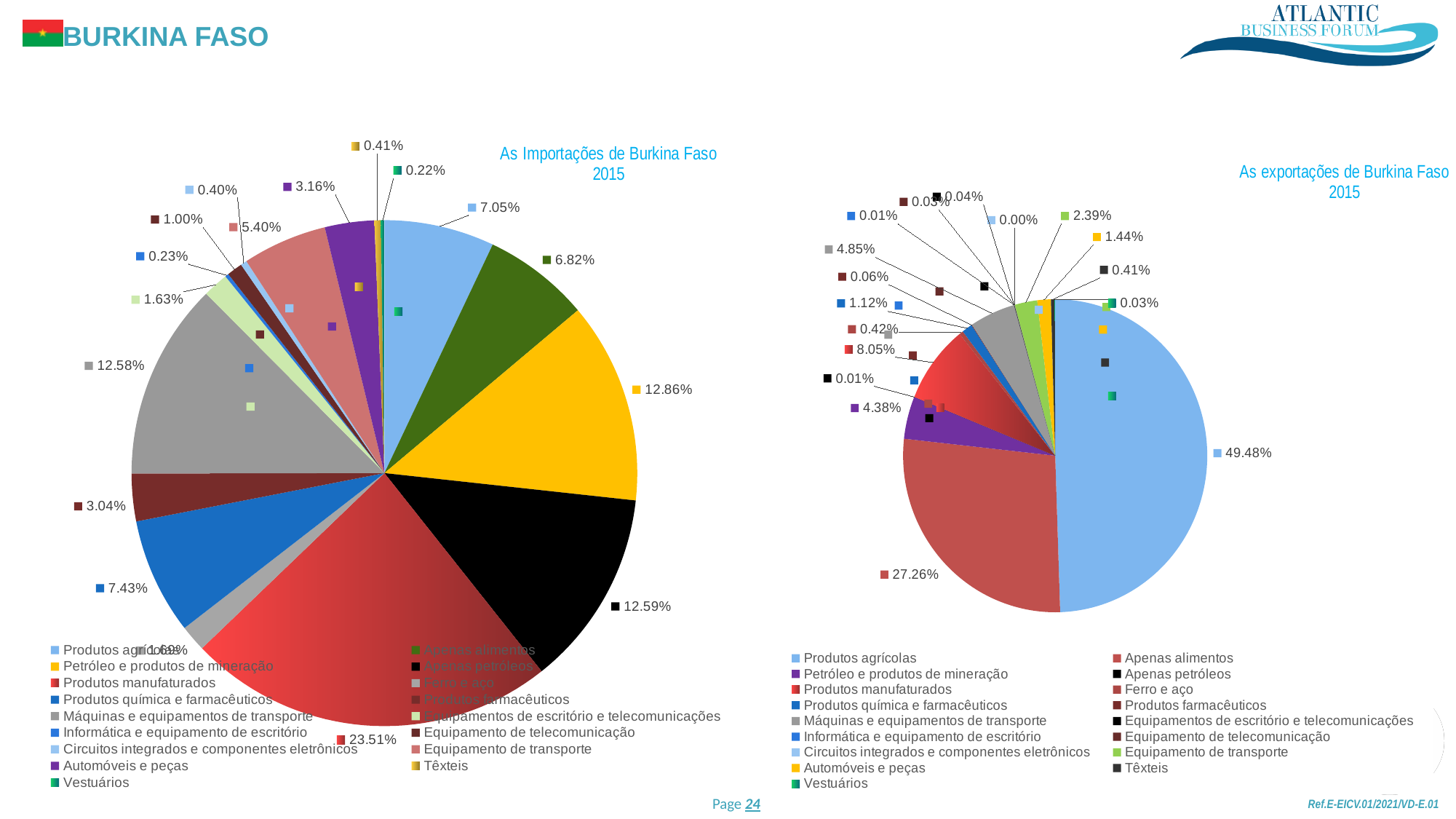
In the chart titled 'As Importações de Burkina Faso 2015', what share is shown for Produtos manufaturados? 23.51% In the chart titled 'As exportações de Burkina Faso 2015', which category has the largest slice? Produtos agrícolas What kind of chart is 'As Importações de Burkina Faso 2015'? Pie chart In the chart titled 'As Importações de Burkina Faso 2015', what is the difference between the shares of Petróleo e produtos de mineração (12.86%) and Apenas alimentos (6.82%)? 6.04% In the chart titled 'As exportações de Burkina Faso 2015', what share is shown for Produtos agrícolas? 49.48% In the chart titled 'As Importações de Burkina Faso 2015', which is larger: the share for Produtos química e farmacêuticos or the share for Automóveis e peças? Produtos química e farmacêuticos In the chart titled 'As exportações de Burkina Faso 2015', which is larger: the share for Produtos manufaturados or the share for Máquinas e equipamentos de transporte? Produtos manufaturados How many categories does the legend of the chart titled 'As exportações de Burkina Faso 2015' list? 17 In the chart titled 'As Importações de Burkina Faso 2015', what share is shown for Máquinas e equipamentos de transporte? 12.58% In the chart titled 'As Importações de Burkina Faso 2015', which category has the largest slice? Produtos manufaturados In the chart titled 'As exportações de Burkina Faso 2015', what share is shown for Apenas alimentos? 27.26% In the chart titled 'As exportações de Burkina Faso 2015', what is the difference between the shares of Produtos agrícolas and Apenas alimentos? 22.22%